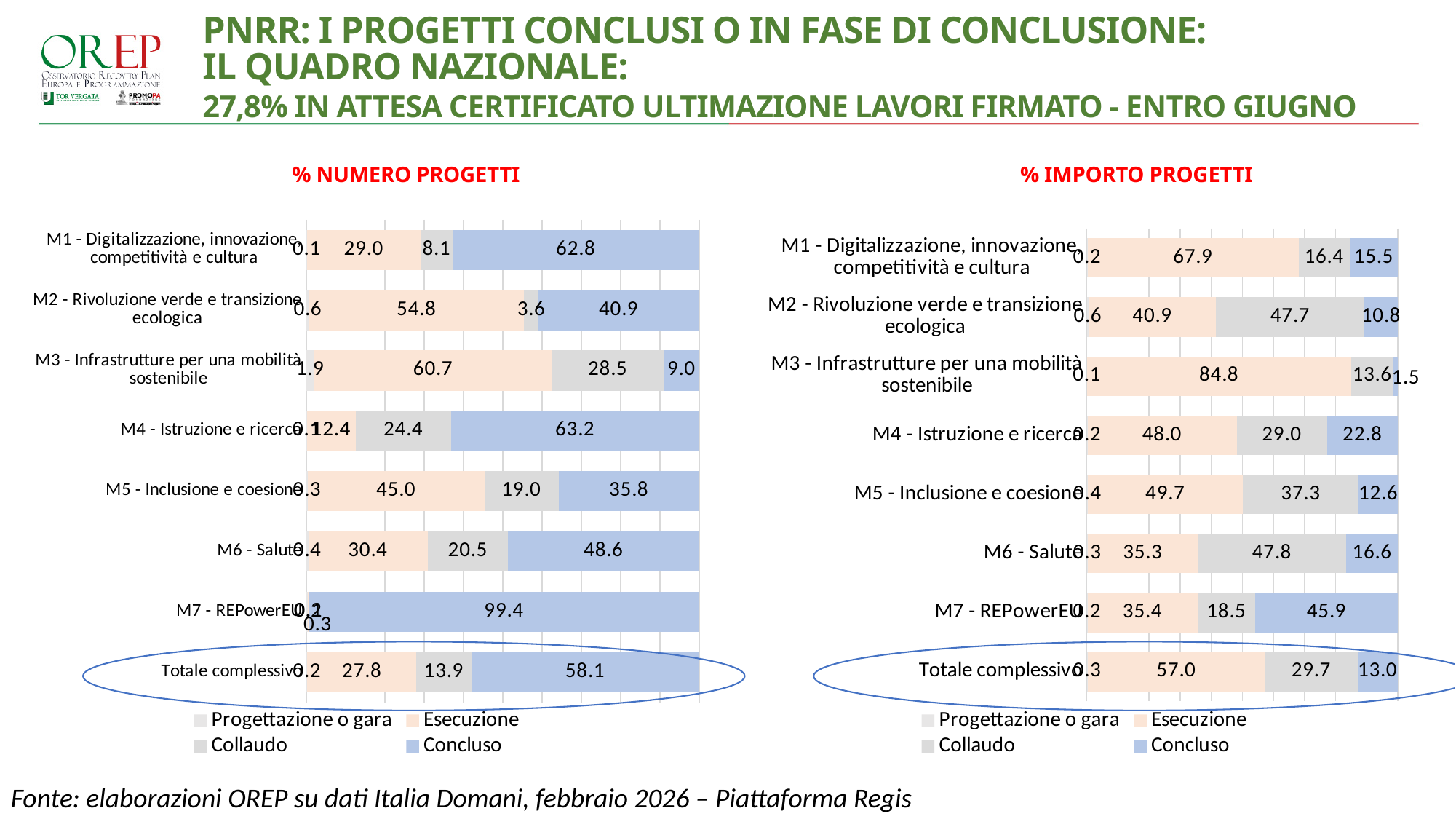
How many categories are shown in the '% NUMERO PROGETTI' chart? 8 In the '% NUMERO PROGETTI' chart, what is the 'Concluso' value for 'Totale complessivo'? 58.1 In the '% IMPORTO PROGETTI' chart, which category has the lowest 'Concluso' value? M3 - Infrastrutture per una mobilità sostenibile In the '% NUMERO PROGETTI' chart, which category has the highest 'Concluso' value? M7 - REPowerEU How many series does the legend of the '% IMPORTO PROGETTI' chart list? 4 What kind of chart is the '% NUMERO PROGETTI' chart? Stacked bar chart In the '% NUMERO PROGETTI' chart, what is the difference between the 'Concluso' values for 'M1 - Digitalizzazione, innovazione, competitività e cultura' and 'M3 - Infrastrutture per una mobilità sostenibile'? 53.8 In the '% IMPORTO PROGETTI' chart, which has the larger 'Collaudo' value: 'M2 - Rivoluzione verde e transizione ecologica' or 'M5 - Inclusione e coesione'? M2 - Rivoluzione verde e transizione ecologica In the '% NUMERO PROGETTI' chart, what is the 'Collaudo' value for 'M3 - Infrastrutture per una mobilità sostenibile'? 28.5 In the '% IMPORTO PROGETTI' chart, what is the 'Esecuzione' value for 'M3 - Infrastrutture per una mobilità sostenibile'? 84.8 In the '% IMPORTO PROGETTI' chart, which category has the highest 'Esecuzione' value? M3 - Infrastrutture per una mobilità sostenibile In the '% IMPORTO PROGETTI' chart, what is the 'Concluso' value for 'M7 - REPowerEU'? 45.9